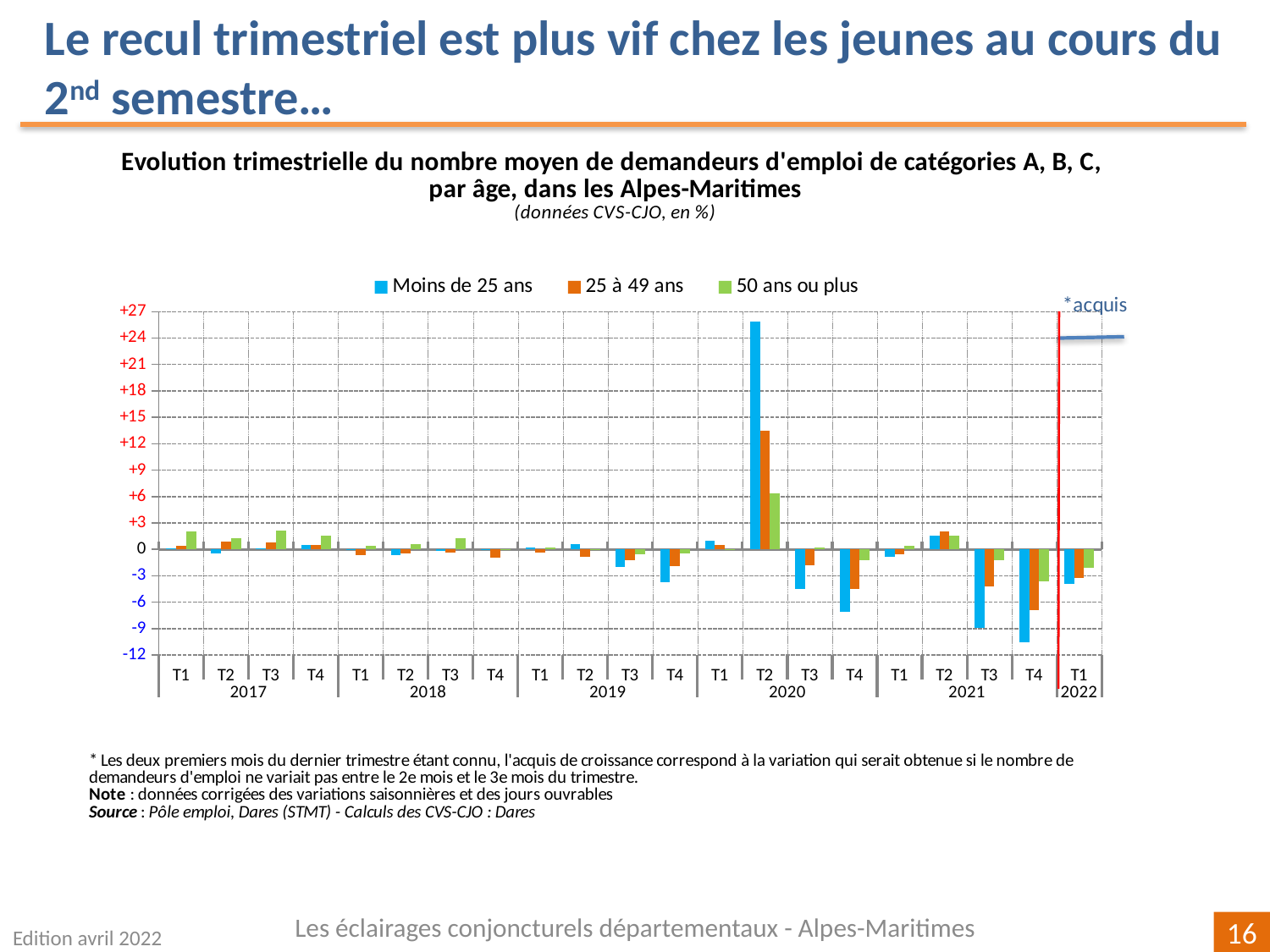
In T2 2020, which series has the larger value: 'Moins de 25 ans' or '25 à 49 ans'? Moins de 25 ans Is the value for '25 à 49 ans' in T2 2020 greater or less than +12? greater Is the value for '25 à 49 ans' in T4 2021 greater or less than -6? less Is the value for 'Moins de 25 ans' in T4 2021 greater or less than -9? less How many series does the legend list? 3 How many quarters are plotted along the x axis? 21 In which quarter does the 'Moins de 25 ans' series reach its lowest value? T4 2021 Which age group series is shown in blue? Moins de 25 ans In which quarter does the 'Moins de 25 ans' series reach its highest value? T2 2020 What kind of chart is shown on the slide? Bar chart